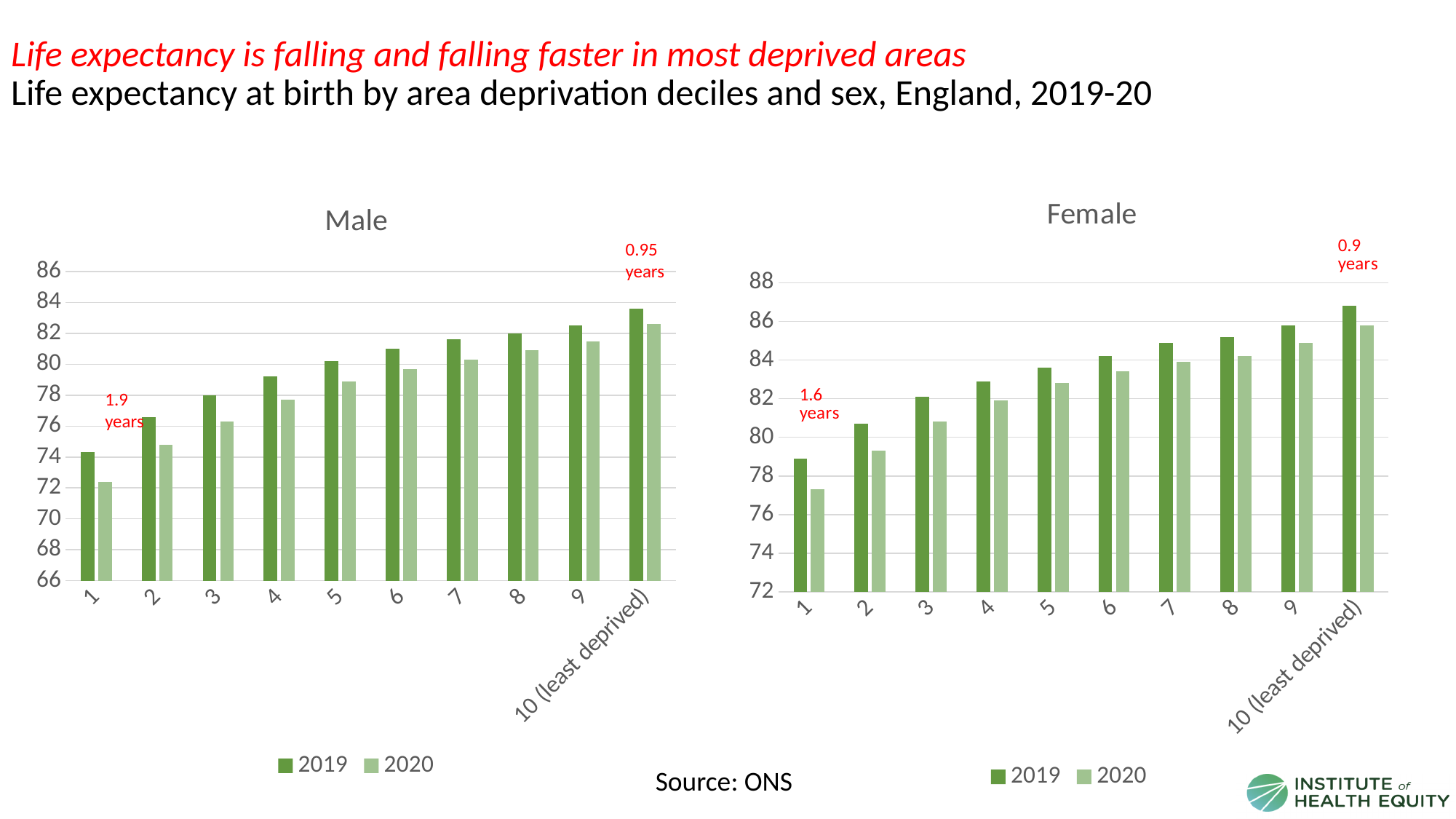
In the Female chart, what drop in life expectancy is annotated for decile 10 (least deprived)? 0.9 years In the Male chart, is the 2020 value for decile 1 greater or less than 74? less What kind of chart is the Male chart? bar chart In the Female chart, which decile has the lowest 2020 life expectancy? 1 In the Male chart, what drop in life expectancy is annotated for decile 1? 1.9 years How many deprivation deciles are shown on the x axis of the Female chart? 10 In the Male chart, do the 2019 values rise or fall as the deciles go from 1 to 10? rise In the Male chart, which decile has the highest 2019 life expectancy? 10 (least deprived) How many series does the legend of the Male chart list? 2 In the Female chart, is the 2019 value for decile 10 (least deprived) greater or less than 86? greater In the Male chart, which is larger for decile 1: the 2019 value or the 2020 value? 2019 In the Female chart, is the 2020 value for decile 1 greater or less than 78? less